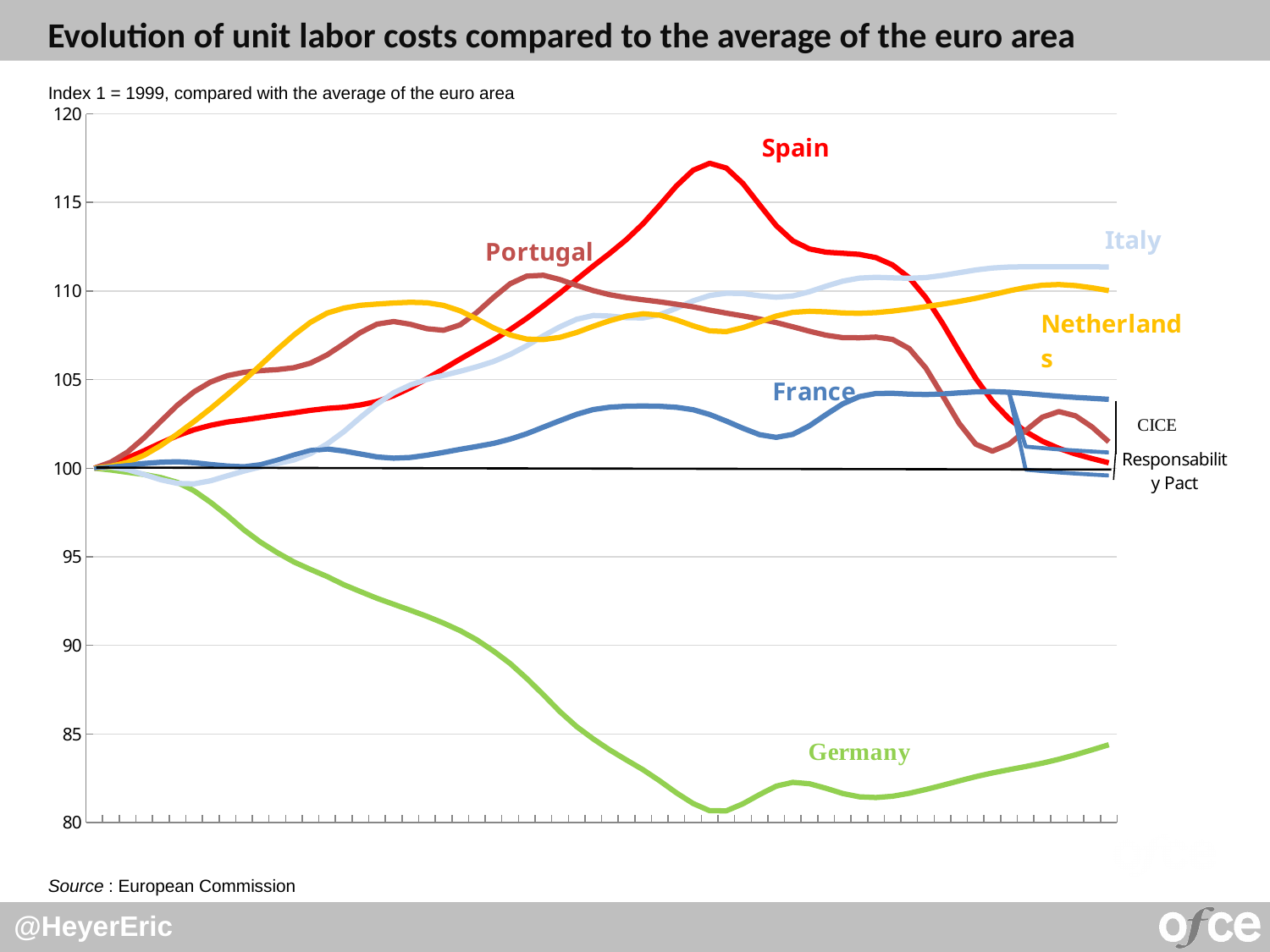
Which country's line falls to the lowest value on the chart? Germany What kind of chart is shown on the slide? line chart How many countries are plotted as lines on the chart? 6 Does Germany's line rise or fall over the first half of the period? fall What source is cited for the chart? European Commission Is the peak value of Spain's line greater or less than 115? greater At the right end of the chart, which line is higher, Italy or France? Italy Is the value of France's line at the right end of the chart greater or less than 105? less Is the lowest point of Germany's line greater or less than 85? less What value do all the lines start at on the left of the chart? 100 Which country's line reaches the highest value on the chart? Spain